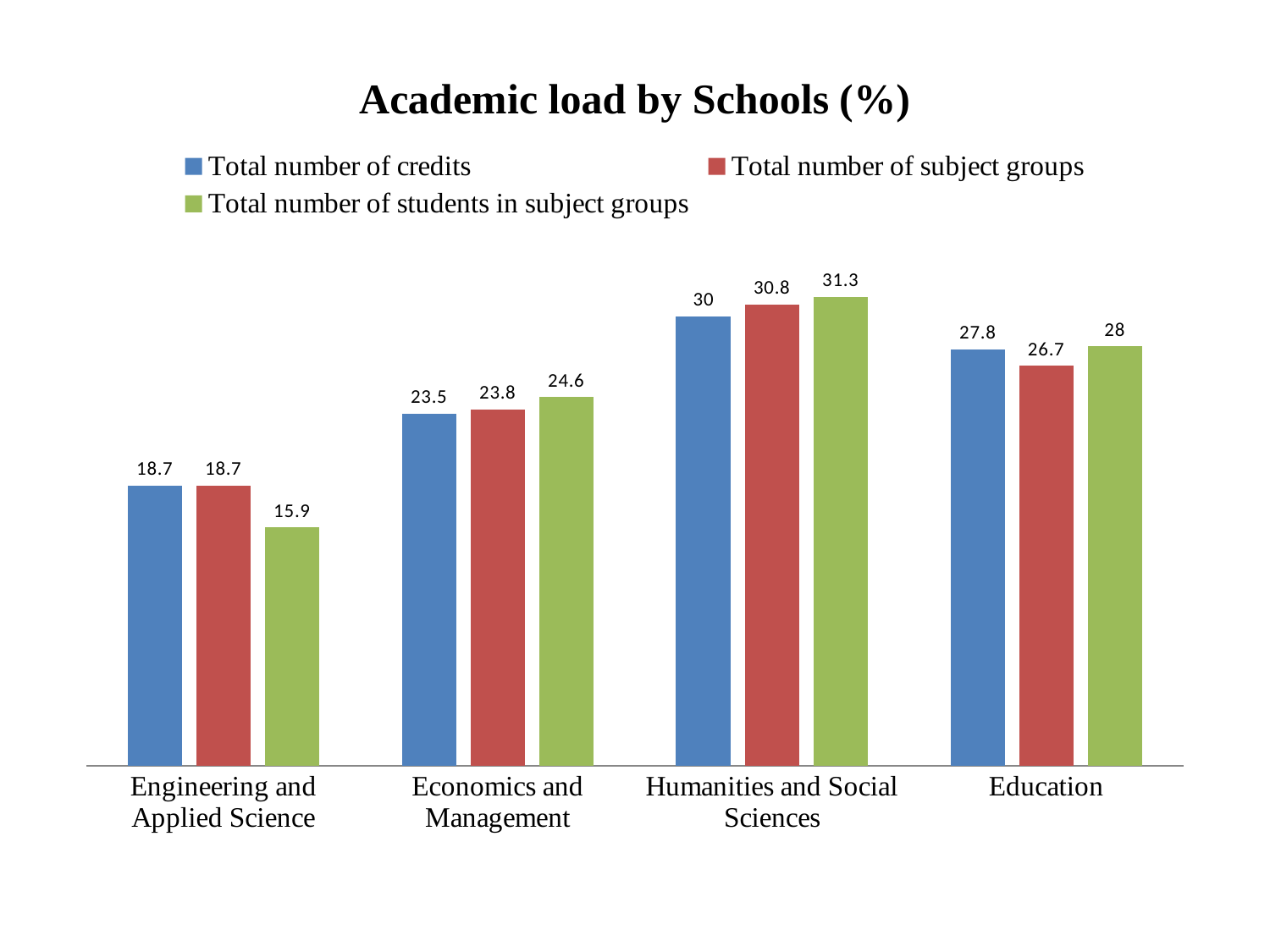
What is the value for Total number of subject groups for Education? 26.7 How many series does the legend list? 3 Which school has the lowest value for Total number of credits? Engineering and Applied Science What kind of chart is shown on the slide? Bar chart Which school has the highest value for Total number of students in subject groups? Humanities and Social Sciences How many schools are shown on the x axis? 4 Which is larger for Education: Total number of credits or Total number of subject groups? Total number of credits What is the value for Total number of credits for Humanities and Social Sciences? 30 What is the difference between Total number of subject groups for Humanities and Social Sciences and for Engineering and Applied Science? 12.1 What is the title of the chart? Academic load by Schools (%) What is the value for Total number of students in subject groups for Engineering and Applied Science? 15.9 What is the difference between Total number of students in subject groups and Total number of credits for Economics and Management? 1.1